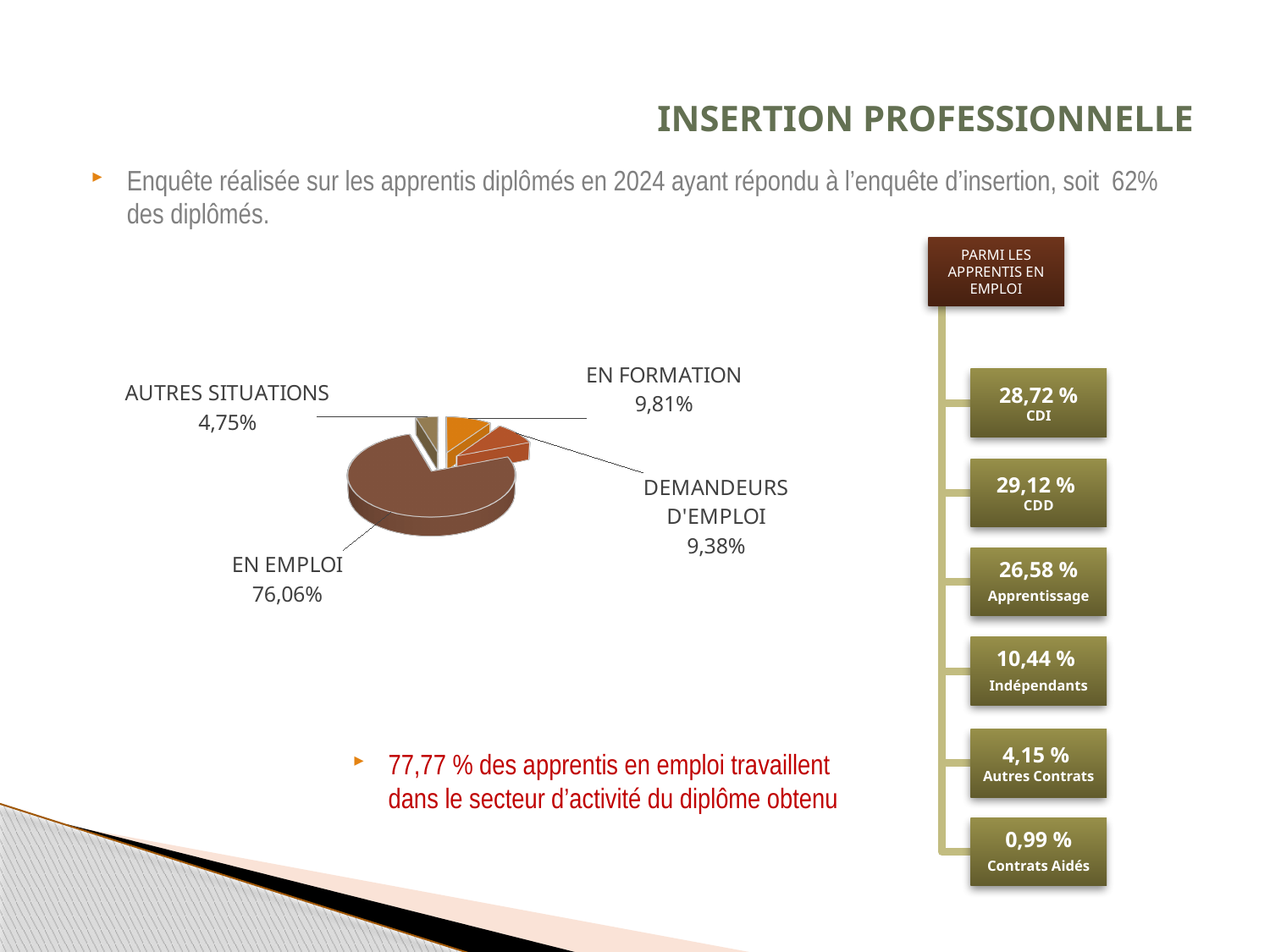
In the pie chart, what is the value for AUTRES SITUATIONS? 4,75% Which category has the largest slice in the pie chart? EN EMPLOI In the pie chart, which is larger: EN FORMATION or DEMANDEURS D'EMPLOI? EN FORMATION In the pie chart, what is the value for DEMANDEURS D'EMPLOI? 9,38% How many slices does the pie chart have? 4 In the pie chart, what is the difference between EN EMPLOI and AUTRES SITUATIONS? 71,31% What share of the pie does EN EMPLOI represent? 76,06% In the pie chart, what is the value for EN EMPLOI? 76,06% What kind of chart is shown on the left of the slide? Pie chart In the pie chart, what is the difference between EN FORMATION and DEMANDEURS D'EMPLOI? 0,43% In the pie chart, what is the value for EN FORMATION? 9,81% Which category has the smallest slice in the pie chart? AUTRES SITUATIONS